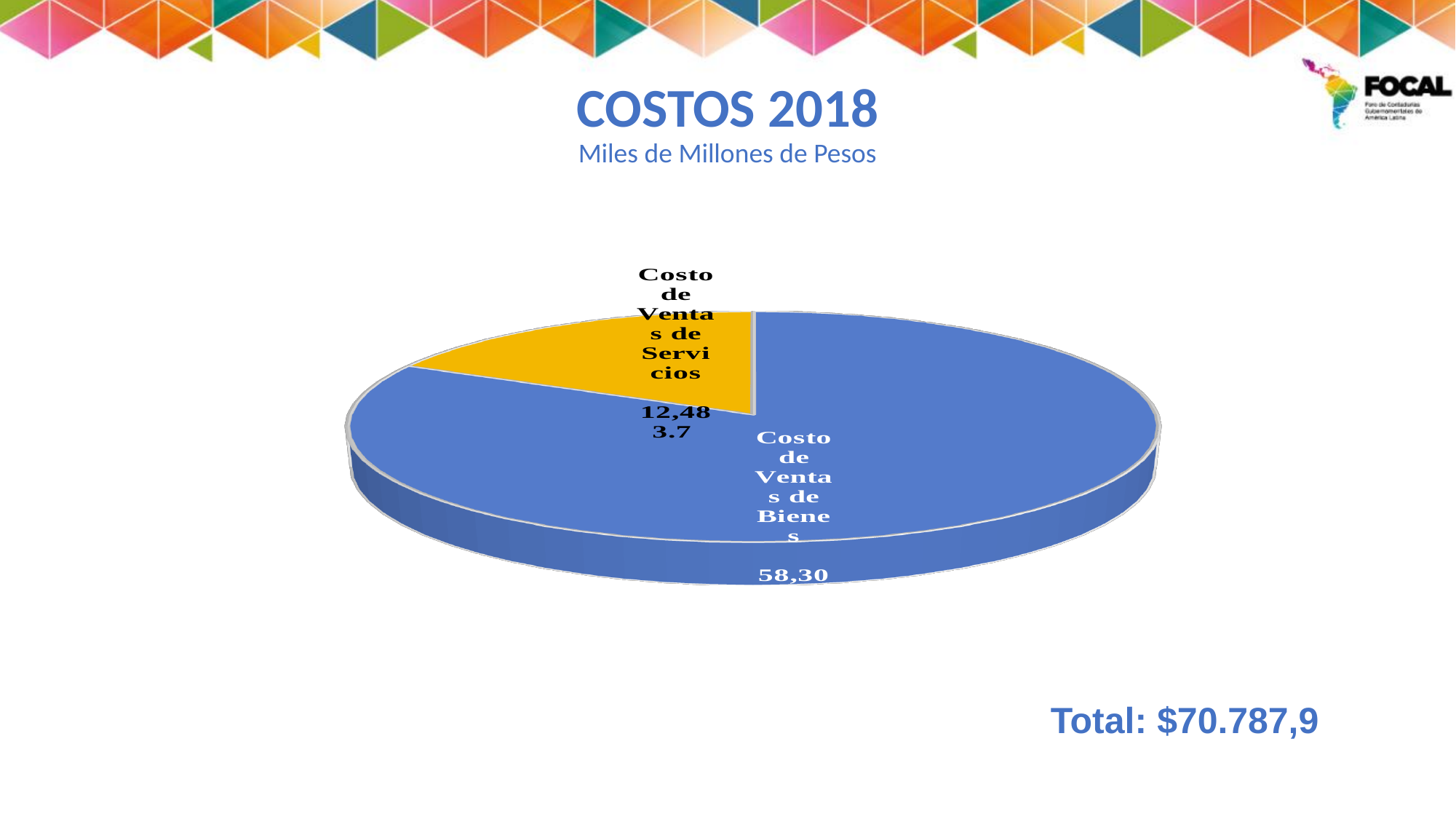
Which category has the largest slice of the pie? Costo de Ventas de Bienes How many slices does the pie chart have? 2 What colour is the Costo de Ventas de Servicios slice? yellow What kind of chart is shown on the slide? pie chart What is the title of the chart on the slide? COSTOS 2018 Which is larger, Costo de Ventas de Bienes or Costo de Ventas de Servicios? Costo de Ventas de Bienes Which category has the smallest slice of the pie? Costo de Ventas de Servicios What is the value shown for Costo de Ventas de Servicios? 12,483.7